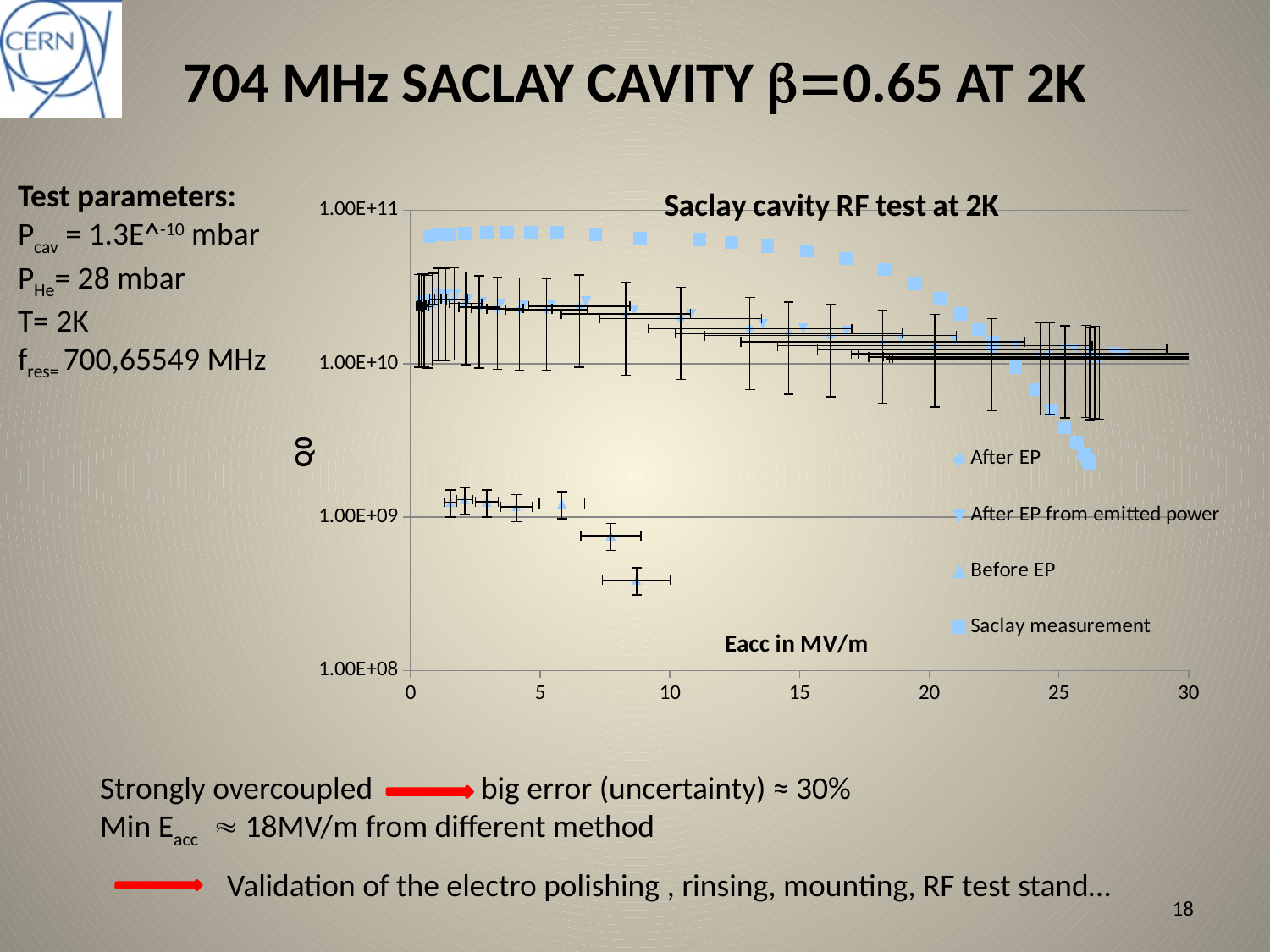
What is the title of the chart? Saclay cavity RF test at 2K Which series has lower Q0 values at Eacc around 5 MV/m, Before EP or Saclay measurement? Before EP What type of chart is shown on the slide? scatter chart Does the Q0 of the Saclay measurement series rise or fall as Eacc increases? fall What is the maximum value shown on the x axis of the chart? 30 Is the Q0 value of the Before EP series at Eacc around 8 MV/m greater or less than 1.00E+09? less Is the Q0 value of the Saclay measurement series at Eacc around 26 MV/m greater or less than 1.00E+10? less What is the label of the y axis of the chart? Q0 Is the Q0 value of the Saclay measurement series at Eacc around 5 MV/m greater or less than 1.00E+10? greater How many series does the chart legend list? 4